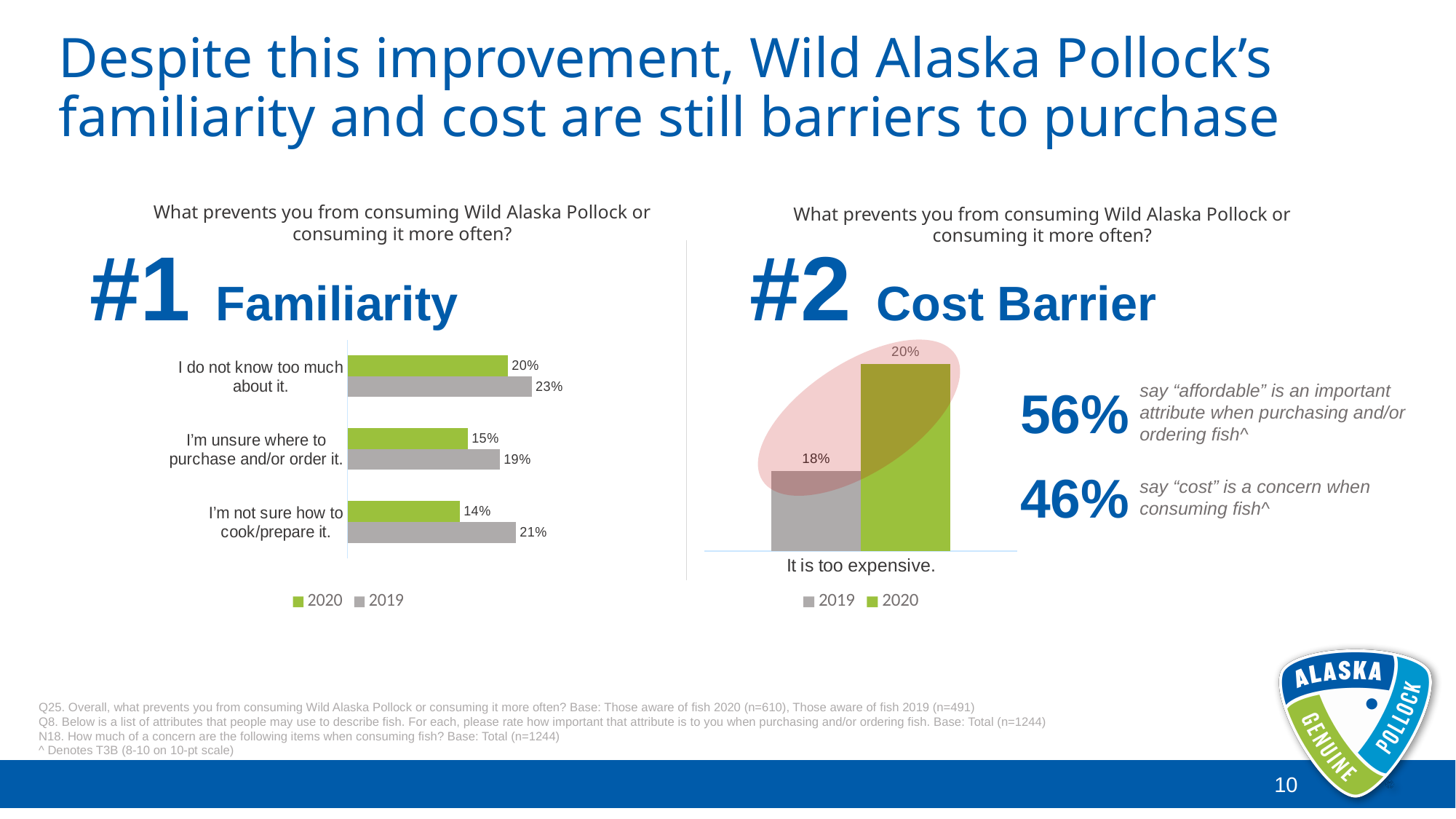
In the Cost Barrier chart on the right, what is the 2020 value for "It is too expensive."? 20% In the Familiarity chart on the left, what is the 2019 value for "I'm not sure how to cook/prepare it."? 21% In the Familiarity chart on the left, which category has the lowest 2020 value? I'm not sure how to cook/prepare it. In the Familiarity chart on the left, what is the difference between the 2019 and 2020 values for "I'm not sure how to cook/prepare it."? 7% In the Familiarity chart on the left, what is the 2020 value for "I do not know too much about it."? 20% In the Familiarity chart on the left, how many series does the legend list? 2 What type of chart is the Familiarity chart on the left? Bar chart In the Familiarity chart on the left, how many categories are shown? 3 In the Cost Barrier chart on the right, what is the difference between the 2020 and 2019 values for "It is too expensive."? 2% In the Familiarity chart on the left, which category has the highest 2019 value? I do not know too much about it. In the Cost Barrier chart on the right, is the 2019 or 2020 value for "It is too expensive." larger? 2020 In the Familiarity chart on the left, what is the 2019 value for "I'm unsure where to purchase and/or order it."? 19%